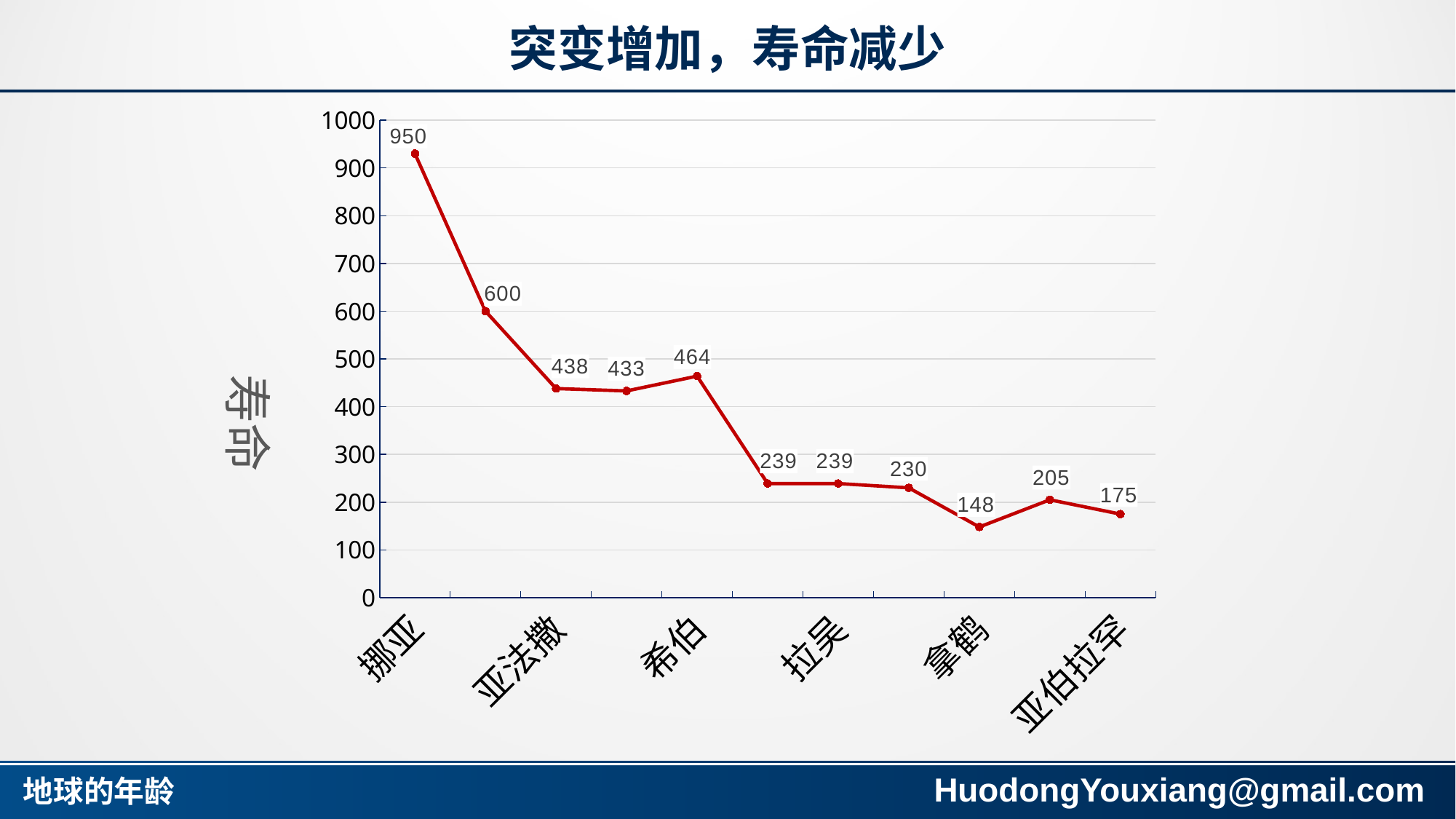
What is the difference between the values for 挪亚 and 亚伯拉罕? 775 What is the value for 拉吴? 239 What is the value for 亚法撒? 438 What is the value for 拿鹤? 148 Do the values generally rise or fall from left to right along the x axis? fall What is the value for 希伯? 464 Which labeled category has the lowest value? 拿鹤 Which labeled category has the highest value? 挪亚 What is the value for 亚伯拉罕? 175 What kind of chart is shown on the slide? line chart Which is larger, the value for 希伯 or the value for 亚法撒? 希伯 What is the value for 挪亚? 950